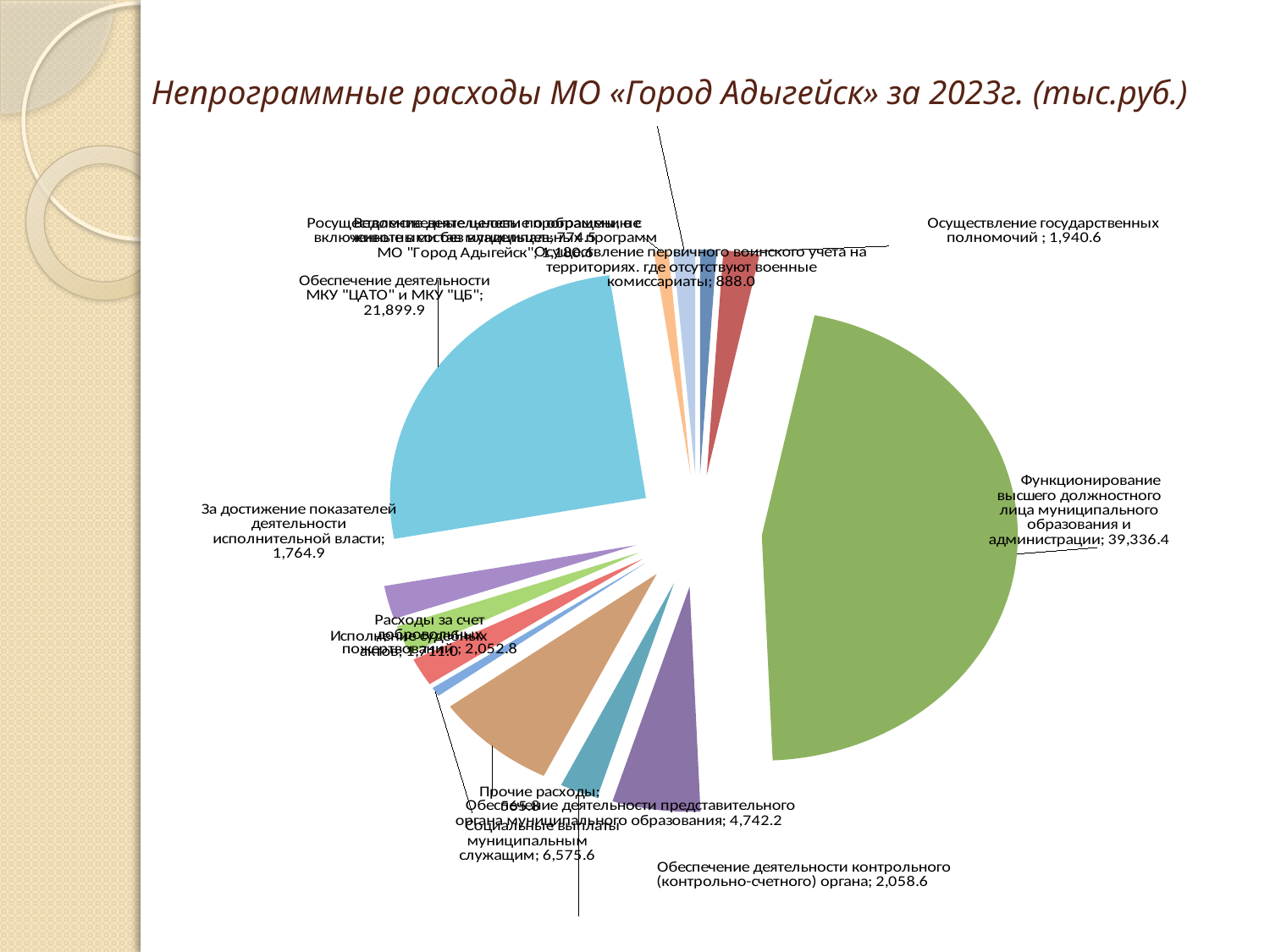
What is the value for «Осуществление государственных полномочий»? 1,940.6 What is the value for «Функционирование высшего должностного лица муниципального образования и администрации»? 39,336.4 What type of chart is shown on the slide? pie chart What is the title of the chart? Непрограммные расходы МО «Город Адыгейск» за 2023г. (тыс.руб.) What is the value for «Социальные выплаты муниципальным служащим»? 6,575.6 Which is larger: «Социальные выплаты муниципальным служащим» or «Обеспечение деятельности представительного органа муниципального образования»? Социальные выплаты муниципальным служащим What is the value for «Обеспечение деятельности МКУ "ЦАТО" и МКУ "ЦБ"»? 21,899.9 What is the value for «Осуществление первичного воинского учета на территориях, где отсутствуют военные комиссариаты»? 888.0 What is the difference between «Функционирование высшего должностного лица муниципального образования и администрации» and «Обеспечение деятельности МКУ "ЦАТО" и МКУ "ЦБ"»? 17,436.5 What is the value for «Обеспечение деятельности контрольного (контрольно-счетного) органа»? 2,058.6 What is the difference between «Обеспечение деятельности контрольного (контрольно-счетного) органа» and «Осуществление государственных полномочий»? 118.0 Which category has the largest slice of the pie? Функционирование высшего должностного лица муниципального образования и администрации